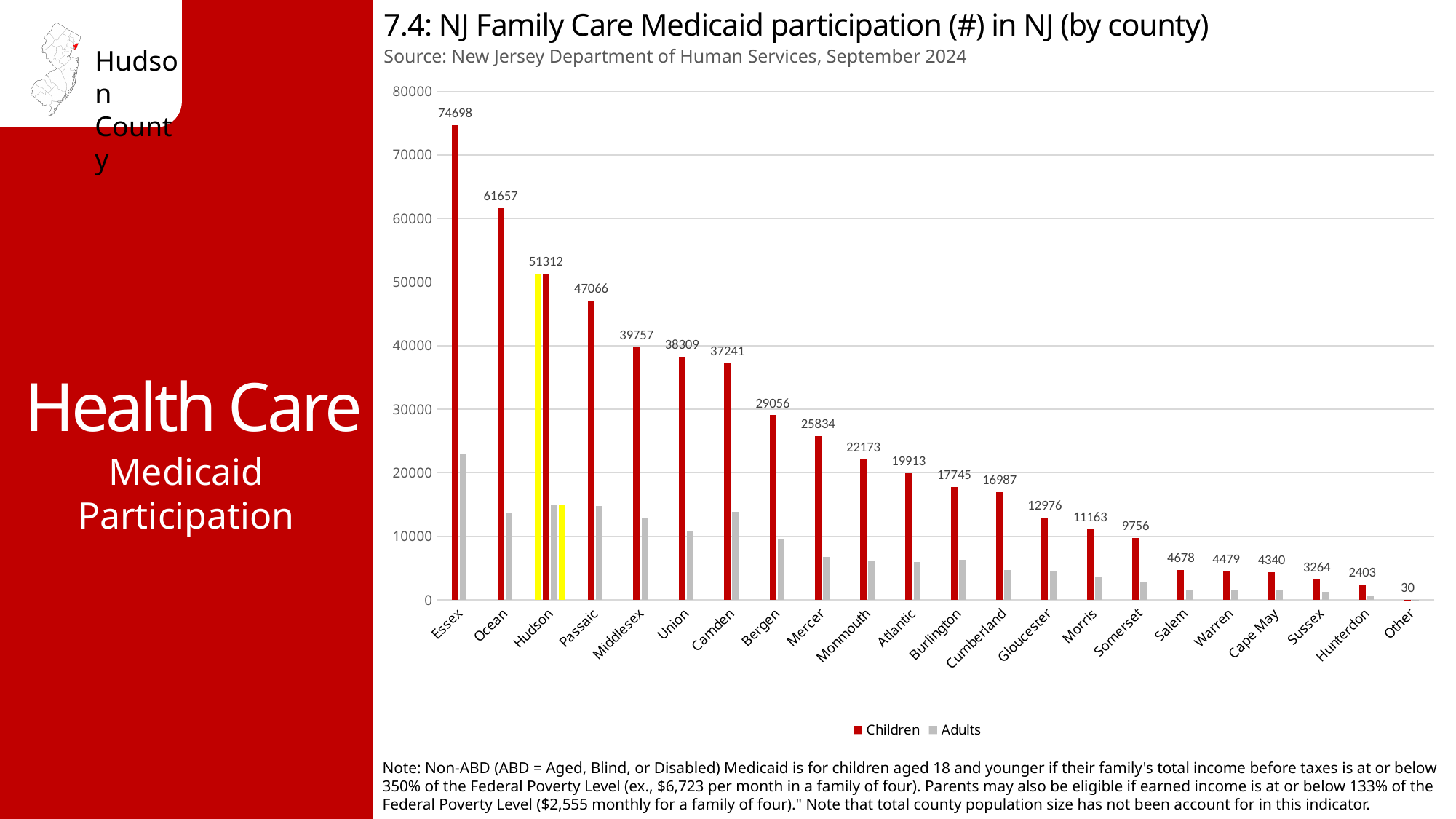
How many series does the legend list? 2 Is the Adults value for Union greater or less than 20000? less Which has a larger Children value, Passaic or Middlesex? Passaic Do the Children values rise or fall from Essex to Hunterdon along the x axis? Fall Which county has the highest Children value? Essex What is the Children value for Hudson? 51312 What kind of chart is shown? Bar chart How many categories are shown on the x axis? 22 Which category has the lowest Children value? Other Is the Adults value for Essex greater or less than 20000? greater What is the difference between the Children values for Essex and Ocean? 13041 What is the Children value for Bergen? 29056